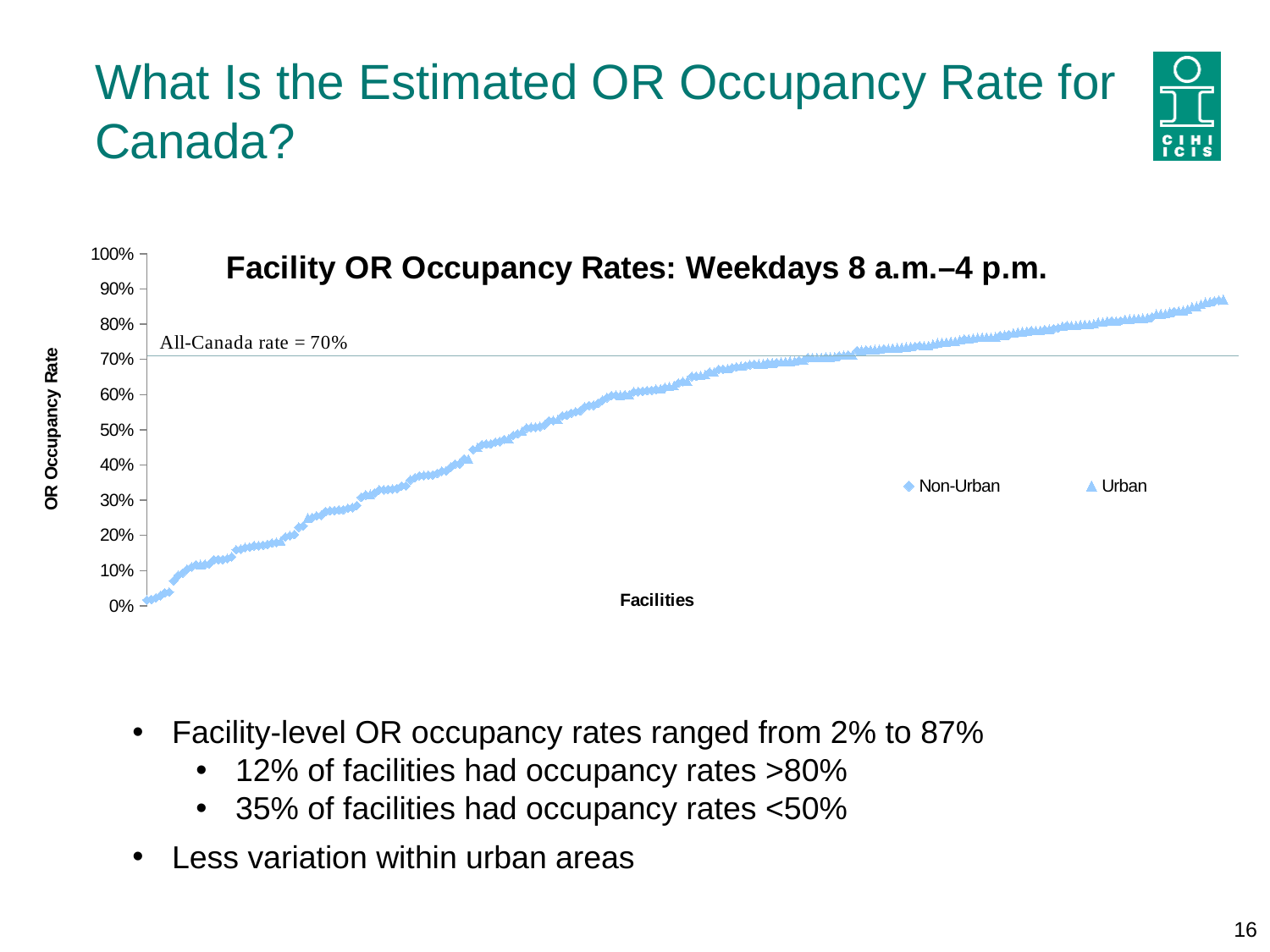
What is the label of the vertical axis? OR Occupancy Rate What kind of chart is shown on the slide? Scatter chart Is the lowest plotted facility occupancy rate greater or less than 10%? less What is the title of the chart? Facility OR Occupancy Rates: Weekdays 8 a.m.–4 p.m. Is the highest plotted facility occupancy rate greater or less than 90%? less What All-Canada rate is marked by the horizontal line on the chart? 70% What are the two series named in the chart legend? Non-Urban and Urban How many series does the chart legend list? 2 Is the highest plotted facility occupancy rate greater or less than 80%? greater Do the plotted occupancy rates rise or fall moving left to right along the x axis? Rise